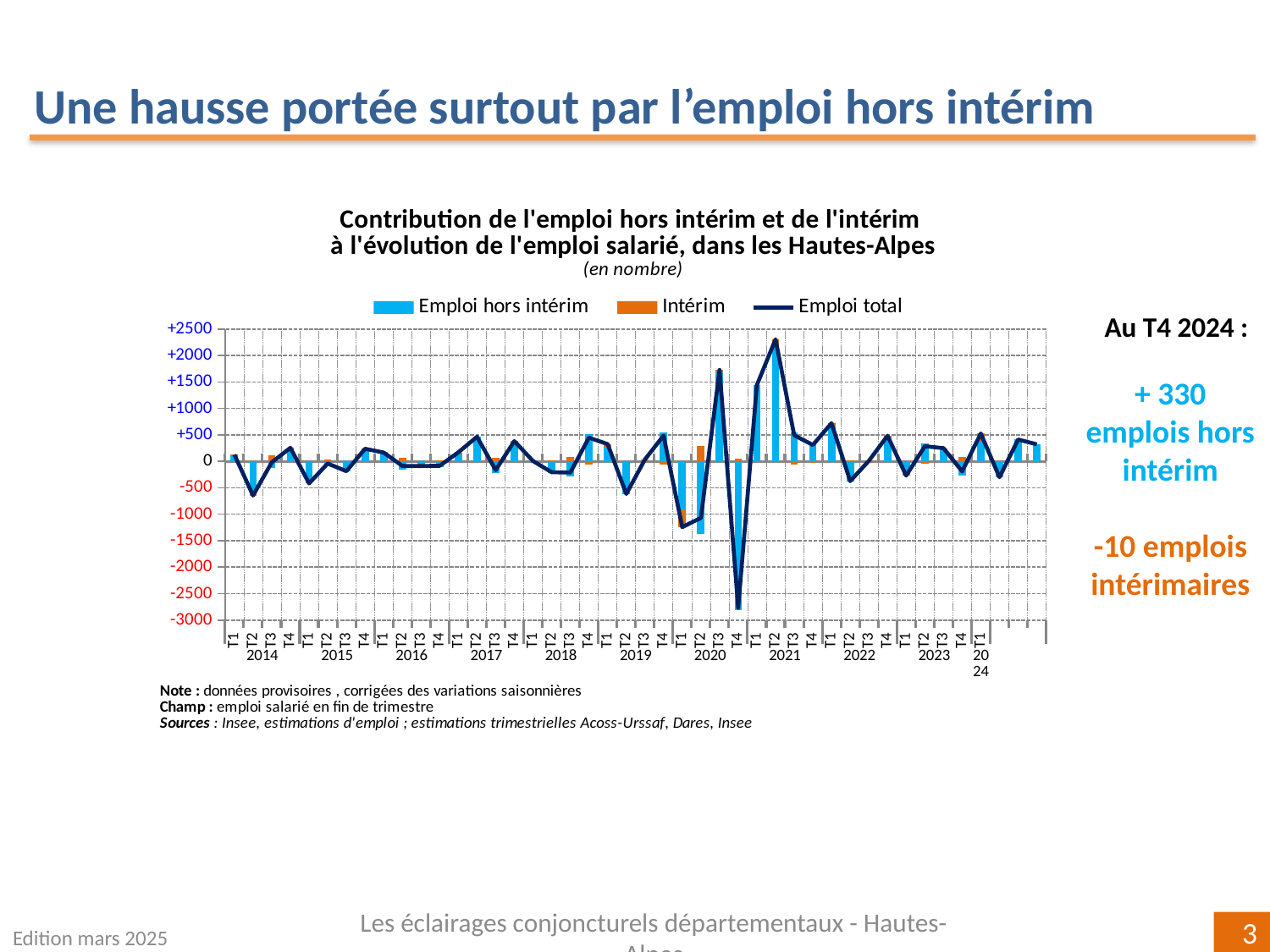
Is the 'Emploi total' value at T4 2020 greater or less than -2500? less Which is larger: the 'Emploi total' value at T2 2021 or at T3 2020? T2 2021 Is the 'Emploi total' value at T2 2021 greater or less than 2000? greater What colour are the 'Intérim' bars in the chart? Orange According to the slide, what is the value for 'Emploi hors intérim' at T4 2024? + 330 What kind of chart is shown on the slide? A combined bar and line chart What is the highest value shown on the vertical axis of the chart? +2500 According to the slide, what is the value for 'Intérim' (emplois intérimaires) at T4 2024? -10 In which quarter does the 'Emploi total' line reach its lowest value? T4 2020 How many series does the chart legend list? 3 Is the 'Emploi total' value at T1 2020 greater or less than -1000? less In which quarter does the 'Emploi total' line reach its highest value? T2 2021